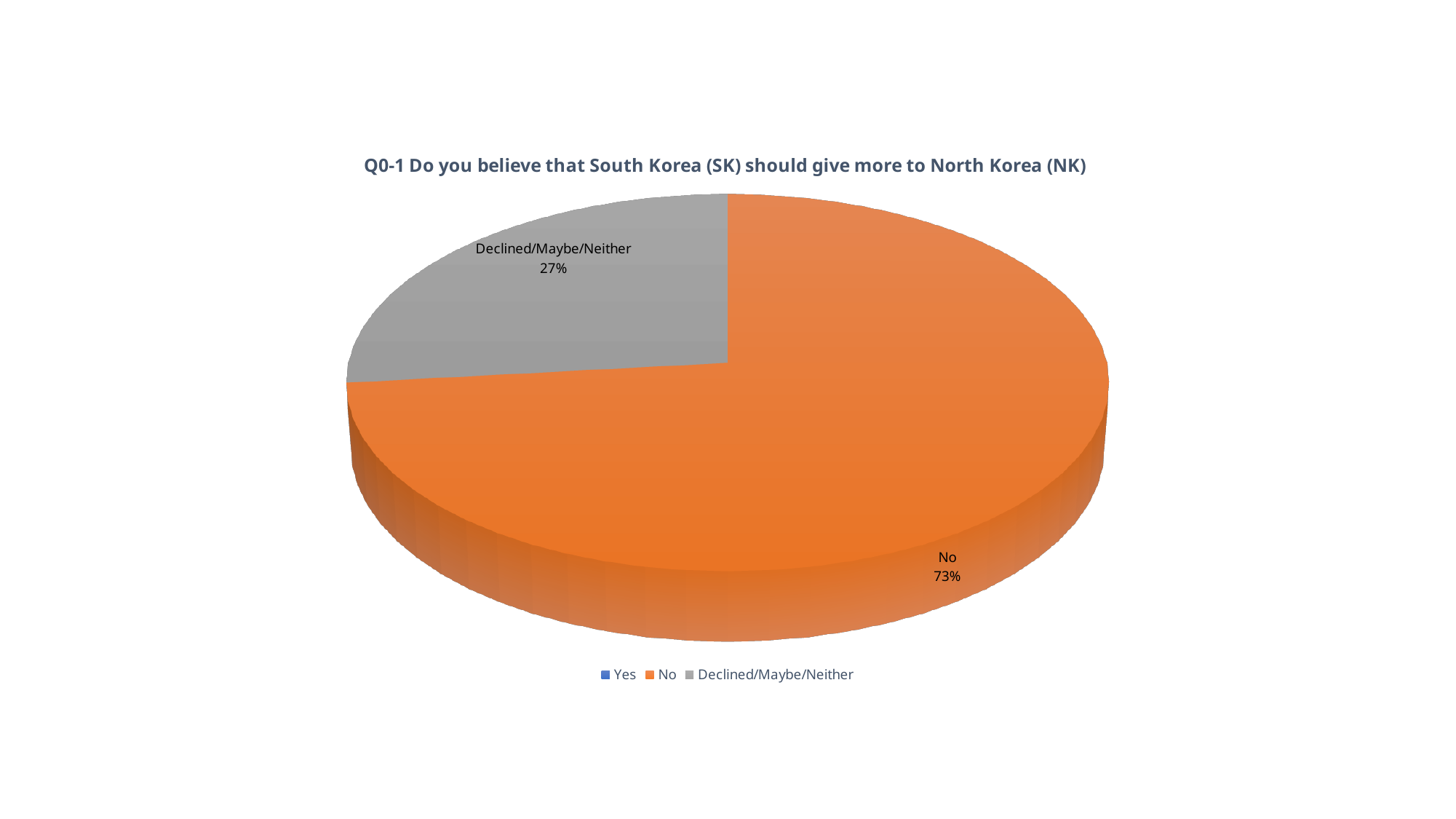
Which category has the largest slice of the pie? No What is the difference in percentage points between the "No" slice and the "Declined/Maybe/Neither" slice? 46 Which is larger, the "No" slice or the "Declined/Maybe/Neither" slice? No What share of the pie does the "Declined/Maybe/Neither" slice represent? 27% How many entries does the legend list? 3 What colour is the "No" slice? Orange What is the title of the chart? Q0-1 Do you believe that South Korea (SK) should give more to North Korea (NK) What kind of chart is shown on the slide? Pie chart How many slices with data labels are visible in the pie? 2 Which of the two labelled slices is smaller, "No" or "Declined/Maybe/Neither"? Declined/Maybe/Neither What share of the pie does the "No" slice represent? 73%